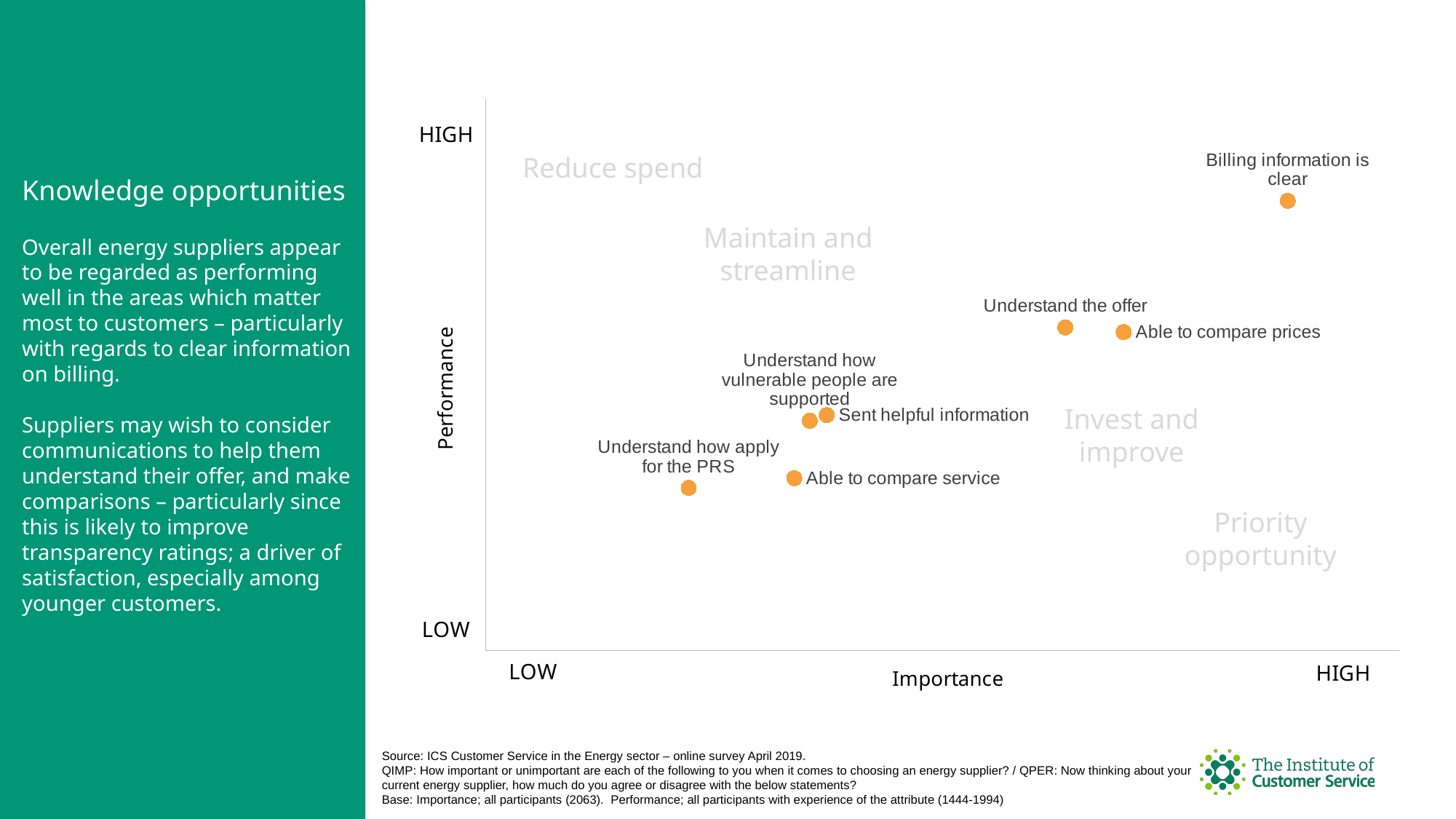
What kind of chart is shown on the slide? Scatter chart Which has higher performance: Billing information is clear or Sent helpful information? Billing information is clear What is the label of the vertical axis? Performance Which attribute has the highest importance on the chart? Billing information is clear What is the label of the horizontal axis? Importance Which attribute has the lowest performance on the chart? Understand how apply for the PRS Which has higher importance: Able to compare prices or Understand how apply for the PRS? Able to compare prices Which has higher performance: Understand the offer or Able to compare service? Understand the offer Which attribute has the lowest importance on the chart? Understand how apply for the PRS As importance increases along the x axis, does performance generally rise or fall? Rise Which attribute has the highest performance on the chart? Billing information is clear How many data points are plotted on the chart? 7